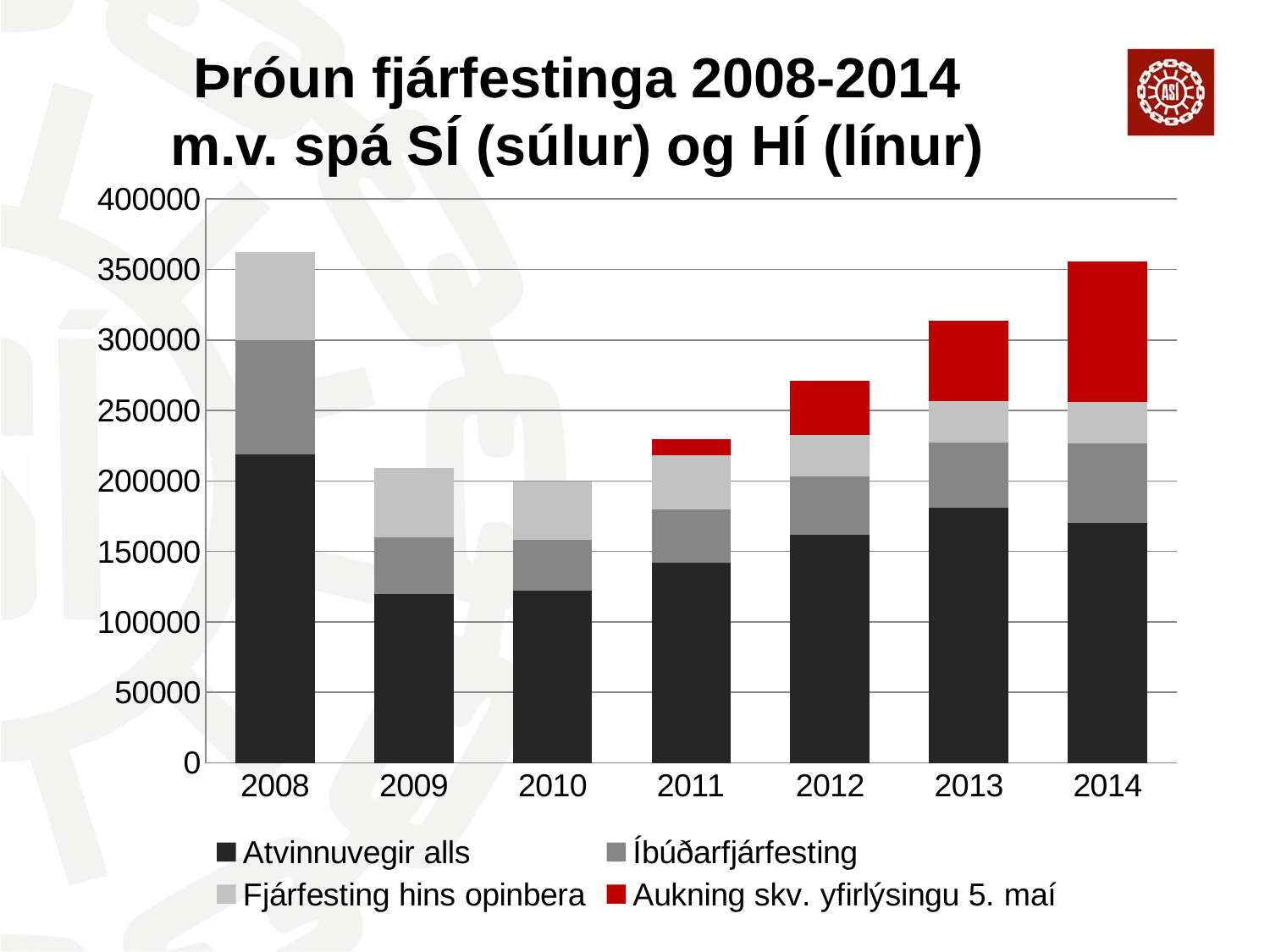
Is the total of the stacked bar for 2011 greater or less than 250000? less How many series does the chart's legend list? 4 Which series is shown in red in the chart? Aukning skv. yfirlýsingu 5. maí How many years are shown on the x axis of the chart? 7 What is the title of the chart on the slide? Þróun fjárfestinga 2008-2014 m.v. spá SÍ (súlur) og HÍ (línur) Is the value of Atvinnuvegir alls for 2008 greater or less than 200000? greater Is the total of the stacked bar for 2008 greater or less than 350000? greater What kind of chart is shown on the slide? Stacked bar chart Do the stacked bar totals rise or fall from 2010 to 2014? Rise Which year has the larger Aukning skv. yfirlýsingu 5. maí segment, 2012 or 2014? 2014